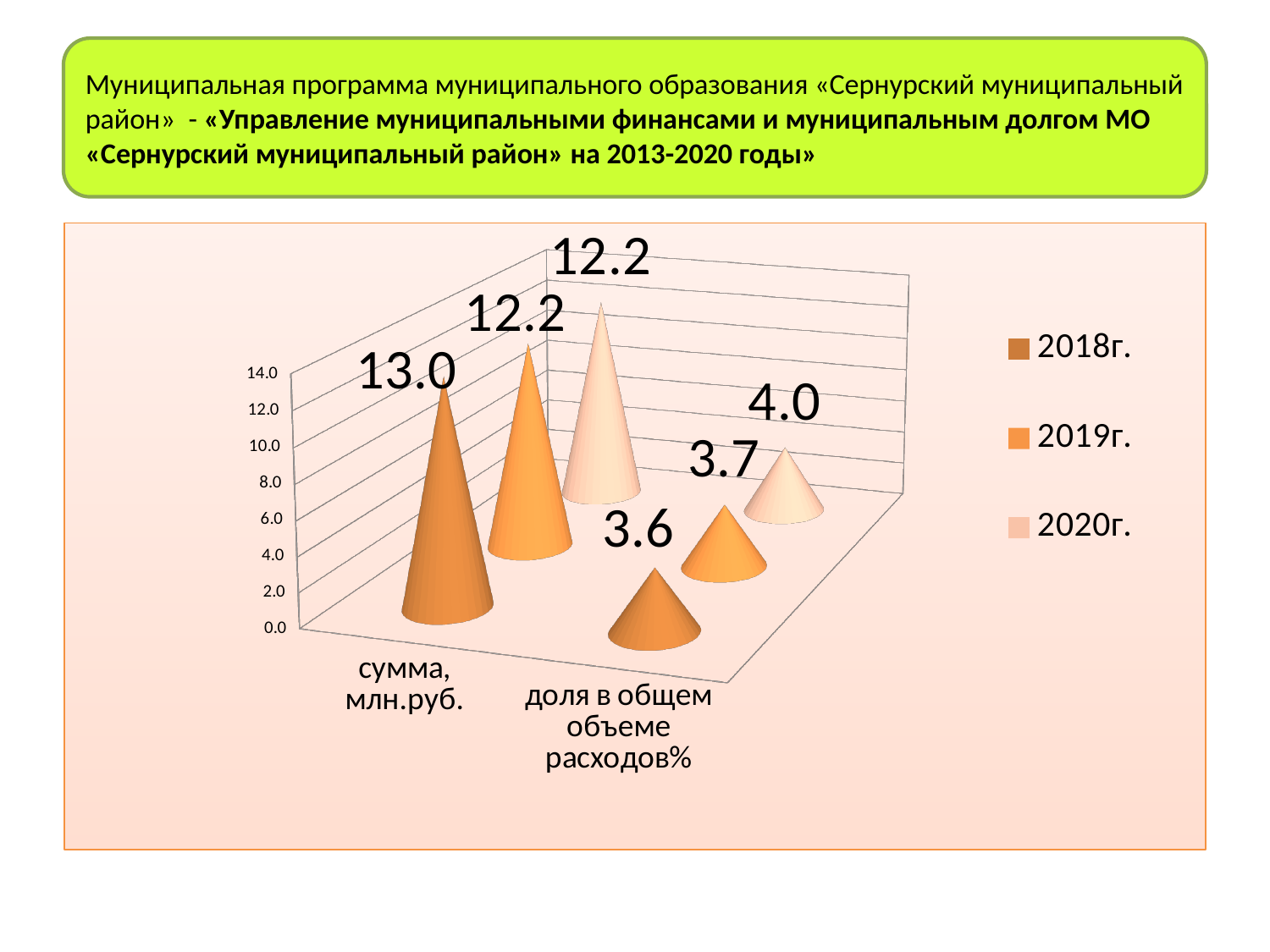
How many series does the legend list? 3 Which year has the highest value in the category «сумма, млн.руб.»? 2018г. Which year has the lowest value in the category «доля в общем объеме расходов%»? 2018г. Which is larger in the category «доля в общем объеме расходов%»: the value for 2019г. or for 2020г.? 2020г. What is the value for 2018г. in the category «сумма, млн.руб.»? 13.0 What is the difference between the 2018г. and 2020г. values in the category «сумма, млн.руб.»? 0.8 How many categories are shown on the x axis? 2 What is the value for 2019г. in the category «доля в общем объеме расходов%»? 3.7 What is the value for 2019г. in the category «сумма, млн.руб.»? 12.2 What is the difference between the 2020г. and 2018г. values in the category «доля в общем объеме расходов%»? 0.4 What is the value for 2020г. in the category «доля в общем объеме расходов%»? 4.0 Do the values in the category «доля в общем объеме расходов%» rise or fall from 2018г. to 2020г.? rise